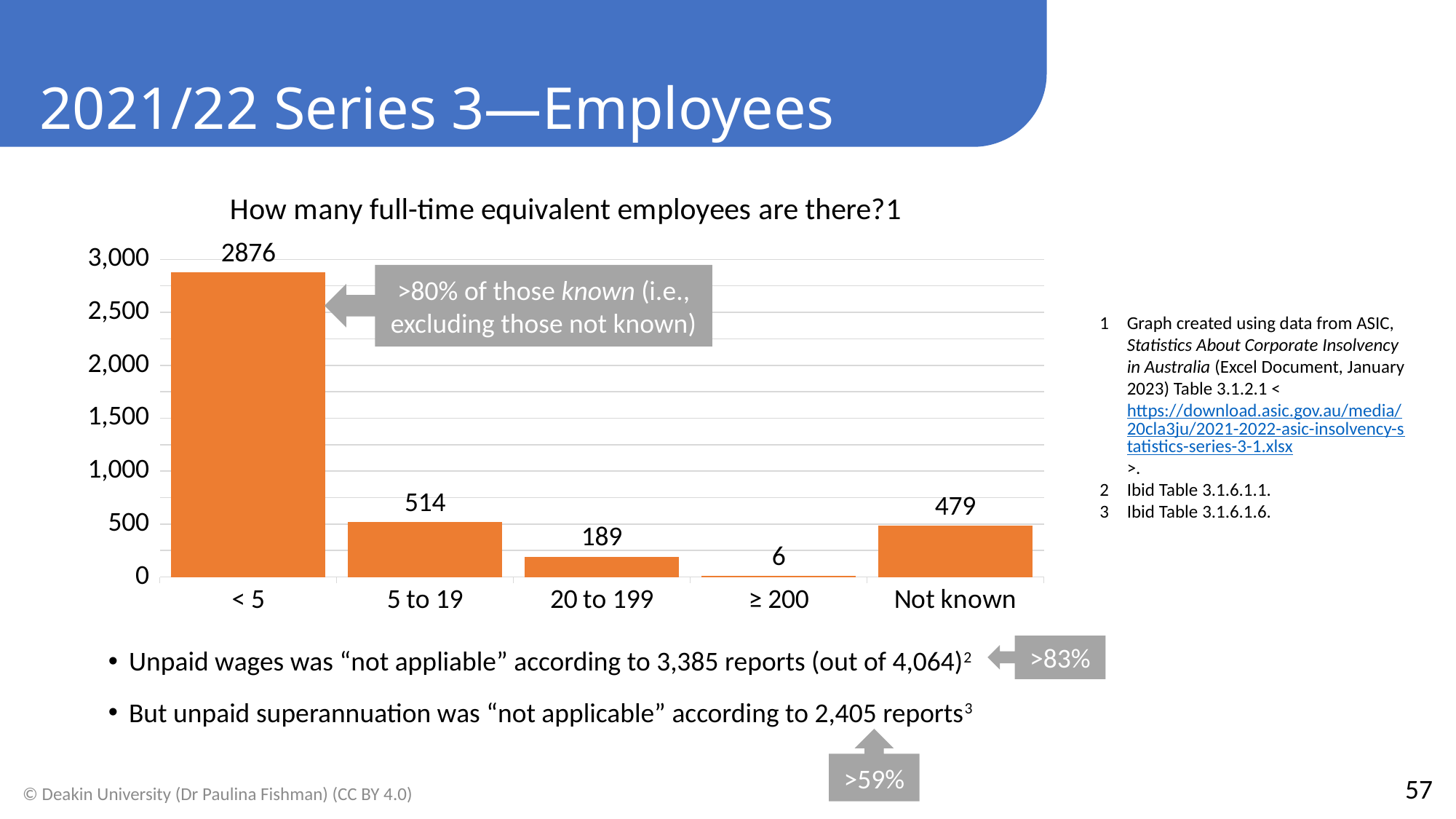
What is the value for the "< 5" category? 2876 Which category has the lowest value? ≥ 200 What is the value for the "Not known" category? 479 Which is larger, the value for "20 to 199" or the value for "Not known"? Not known What kind of chart is shown on the slide? Bar chart What is the value for the "20 to 199" category? 189 How many categories are shown on the x axis? 5 What is the value for the "5 to 19" category? 514 What is the title of the chart? How many full-time equivalent employees are there? What is the value for the "≥ 200" category? 6 Which category has the highest value? < 5 What is the difference between the values for "5 to 19" and "Not known"? 35